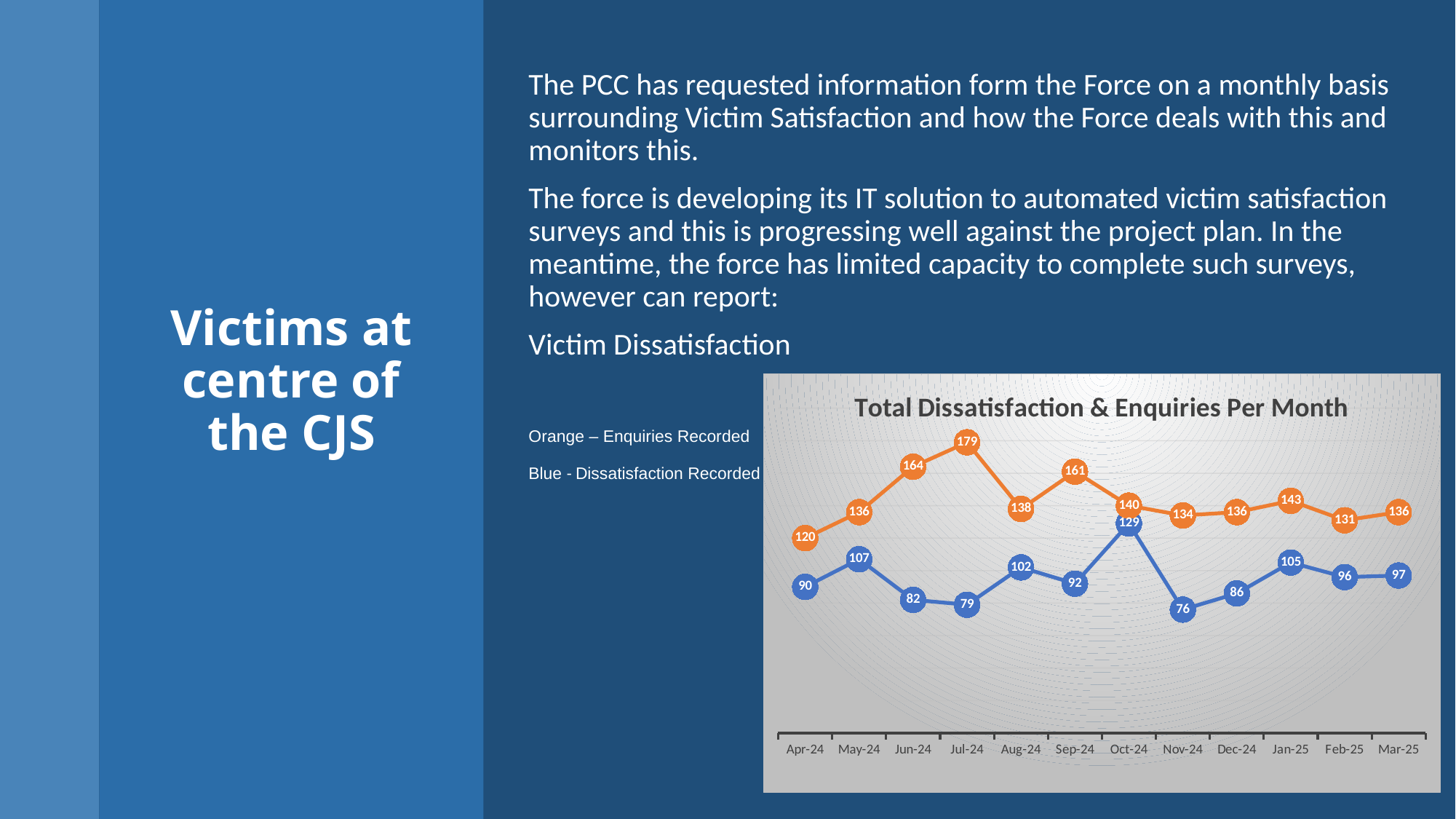
In which month does the Dissatisfaction Recorded (blue) series reach its lowest value? Nov-24 What is the value of Enquiries Recorded (orange line) for Jul-24? 179 Does the Enquiries Recorded (orange) series rise or fall from Jul-24 to Aug-24? fall What type of chart is shown on the slide? line chart In which month does the Enquiries Recorded (orange) series reach its highest value? Jul-24 What is the title of the chart? Total Dissatisfaction & Enquiries Per Month In which month does the Dissatisfaction Recorded (blue) series reach its highest value? Oct-24 What is the value of Dissatisfaction Recorded (blue line) for Nov-24? 76 How many months are plotted along the x axis of the chart? 12 How many data series are plotted in the chart? 2 Which is larger: Dissatisfaction Recorded in May-24 or in Jun-24? May-24 What is the difference between Enquiries Recorded and Dissatisfaction Recorded in Oct-24? 11